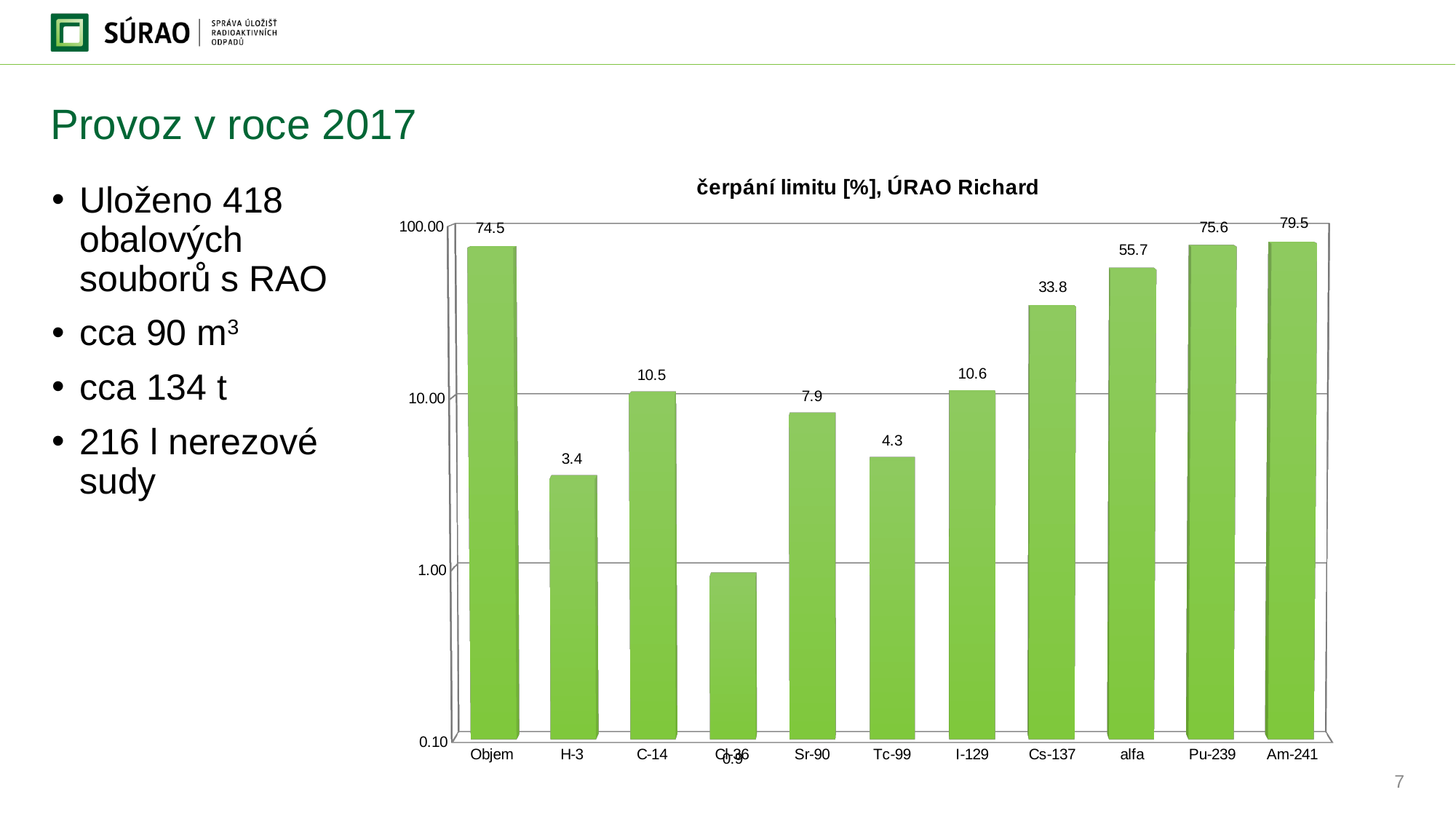
Which is larger, the value for Sr-90 or the value for Tc-99? Sr-90 Which category has the lowest value in the chart? Cl-36 What is the title of the chart? čerpání limitu [%], ÚRAO Richard What is the value for Cs-137 in the chart? 33.8 What is the value for alfa in the chart? 55.7 What kind of chart is shown on the slide? bar chart Is the value for Cl-36 greater or less than 1.00? less What is the difference between the values for Am-241 and Pu-239? 3.9 Which category has the highest value in the chart? Am-241 How many categories are shown on the x axis of the chart? 11 What is the difference between the values for Cs-137 and I-129? 23.2 What is the value for H-3 in the chart? 3.4